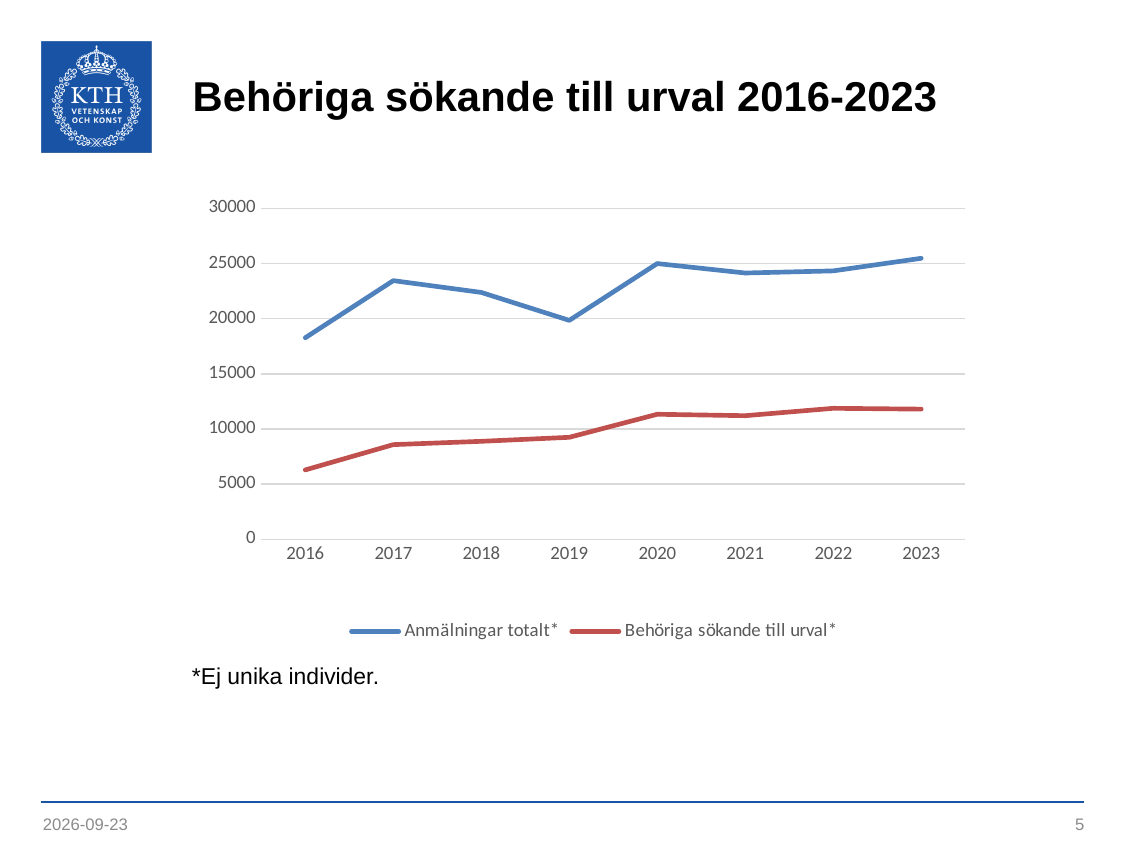
How many series does the legend list? 2 Is the value for Behöriga sökande till urval* in 2023 greater or less than 10000? greater Does the Behöriga sökande till urval* line overall rise or fall from 2016 to 2023? rise What kind of chart is shown on the slide? Line chart Which series is drawn in red? Behöriga sökande till urval* In which year is the value for Behöriga sökande till urval* lowest? 2016 Is the value for Behöriga sökande till urval* in 2017 greater or less than 10000? less Is the value for Anmälningar totalt* in 2016 greater or less than 20000? less In which year is the value for Anmälningar totalt* lowest? 2016 What is the title of the chart? Behöriga sökande till urval 2016-2023 How many years are plotted along the x axis? 8